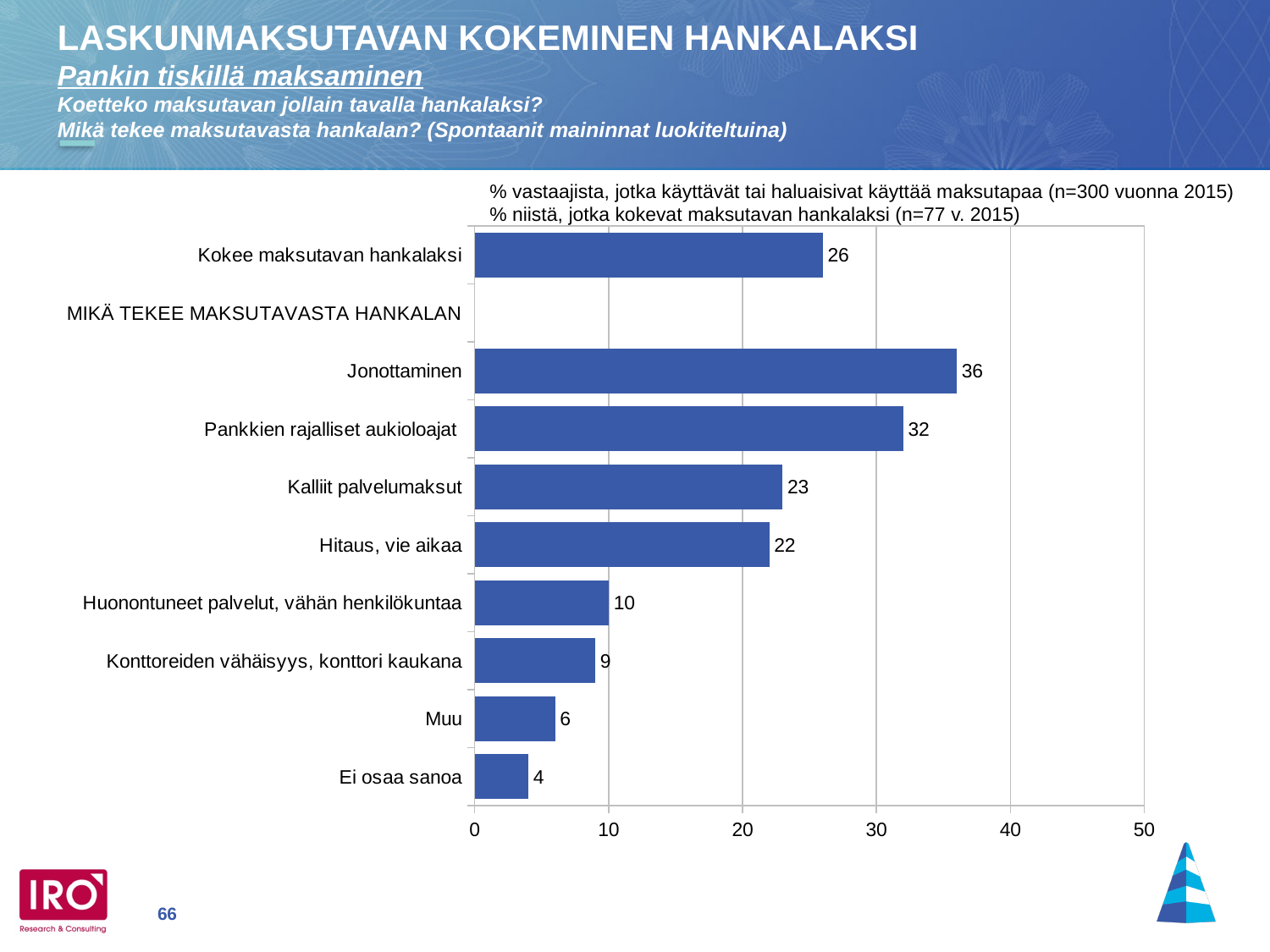
What is the value for Jonottaminen? 36 What is the value for Muu? 6 Which is larger, the value for Kalliit palvelumaksut or the value for Hitaus, vie aikaa? Kalliit palvelumaksut What is the value for Kokee maksutavan hankalaksi? 26 Is the value for Pankkien rajalliset aukioloajat greater or less than 30? greater How many bars are plotted in the chart? 9 What is the difference between the values for Kokee maksutavan hankalaksi and Huonontuneet palvelut, vähän henkilökuntaa? 16 What is the value for Konttoreiden vähäisyys, konttori kaukana? 9 Which category has the highest value? Jonottaminen What kind of chart is shown on the slide? bar chart What is the difference between the values for Jonottaminen and Pankkien rajalliset aukioloajat? 4 Which category has the lowest value? Ei osaa sanoa